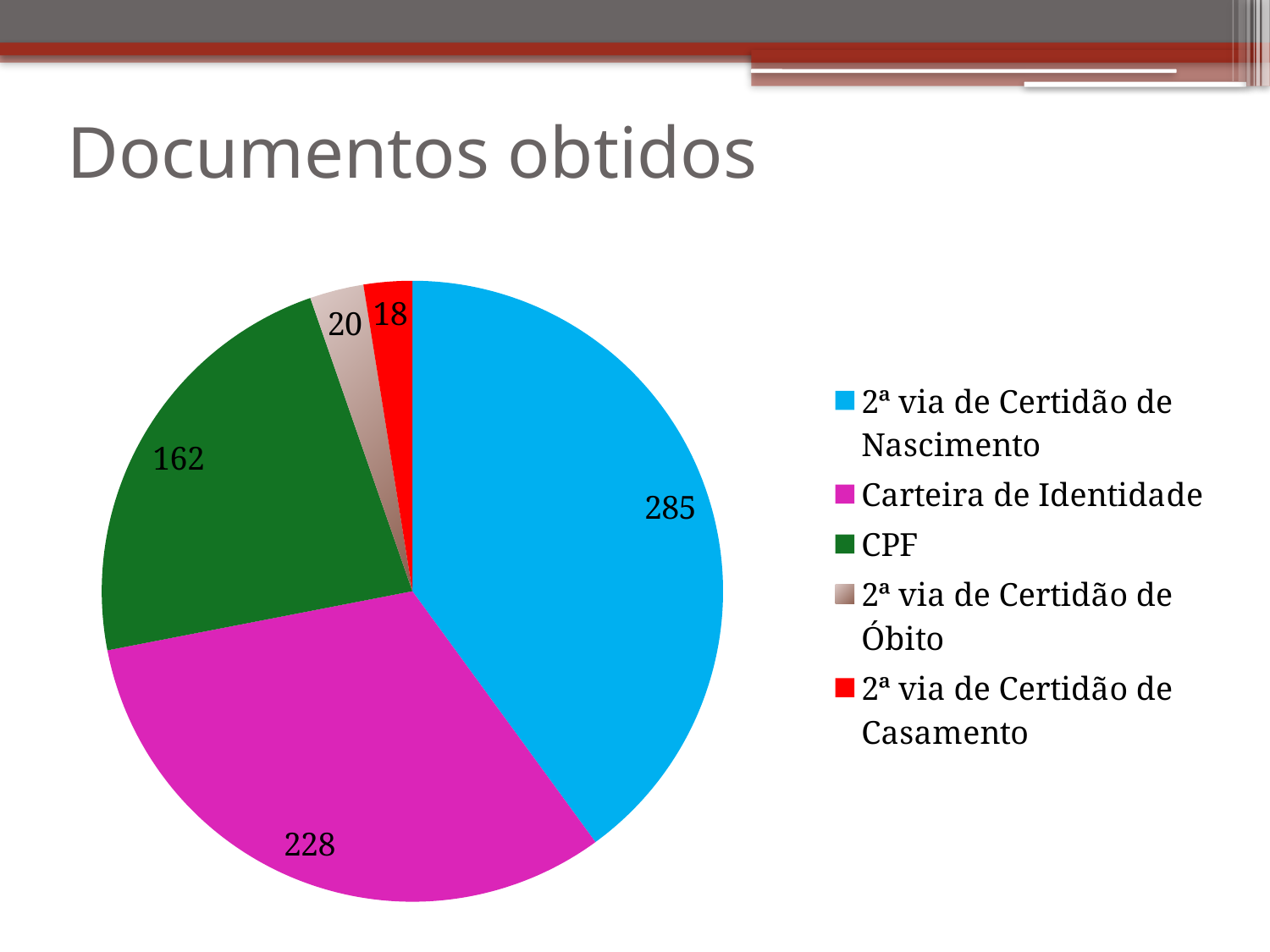
What is the value for 2ª via de Certidão de Nascimento? 285 What is the value for 2ª via de Certidão de Óbito? 20 What is the difference between the values for 2ª via de Certidão de Nascimento and Carteira de Identidade? 57 Which category has the smallest slice? 2ª via de Certidão de Casamento Which category has the largest slice? 2ª via de Certidão de Nascimento Which is larger, the value for CPF or the value for Carteira de Identidade? Carteira de Identidade What is the value for Carteira de Identidade? 228 What is the title of the chart? Documentos obtidos What type of chart is shown on the slide? pie chart What is the value for CPF? 162 What is the value for 2ª via de Certidão de Casamento? 18 How many slices does the pie chart have? 5